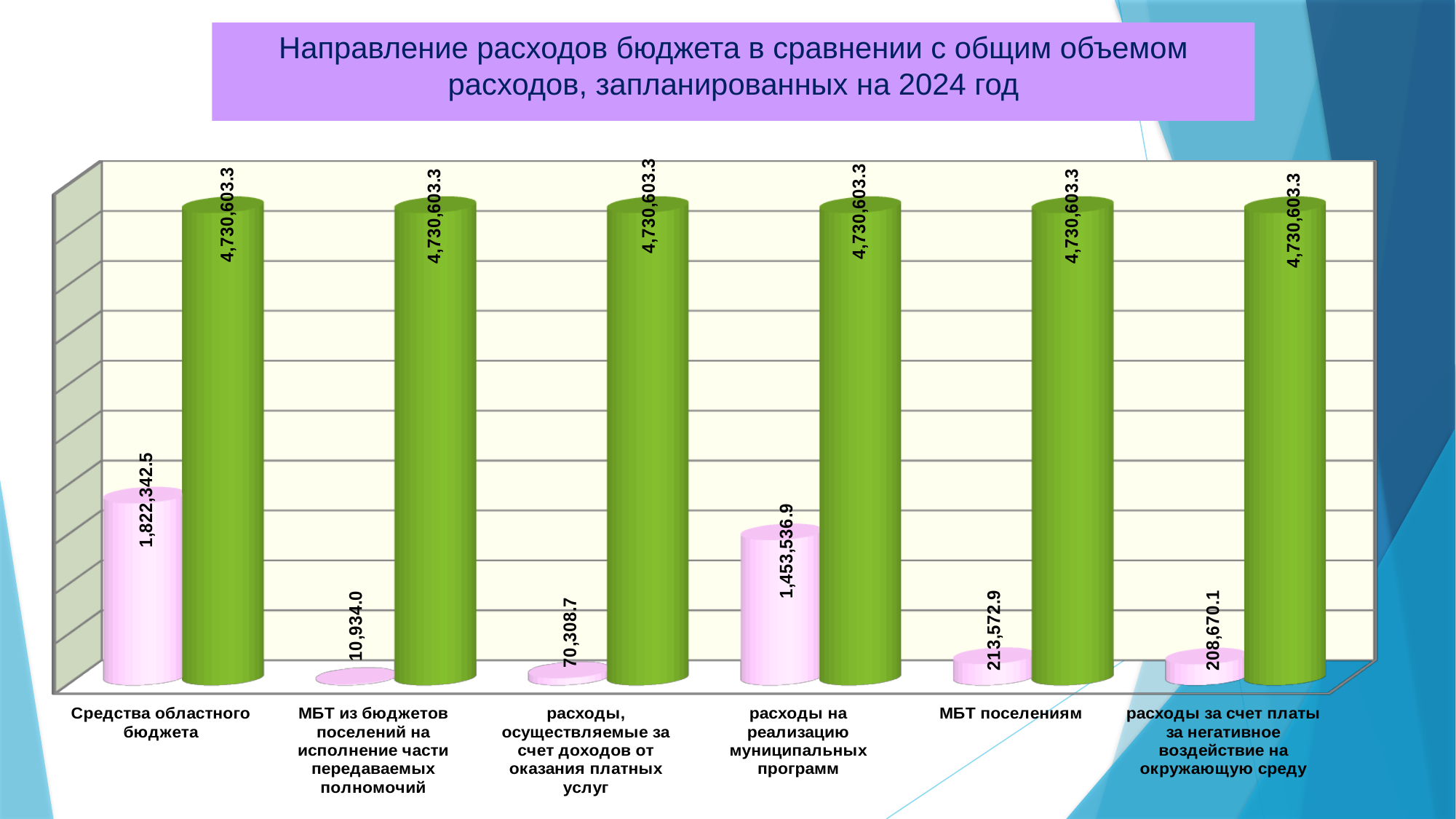
What is the value of the pink bar for "МБТ поселениям"? 213,572.9 What is the title of the chart on the slide? Направление расходов бюджета в сравнении с общим объемом расходов, запланированных на 2024 год What is the value of the pink bar for "расходы, осуществляемые за счет доходов от оказания платных услуг"? 70,308.7 Which category has the lowest pink bar value? МБТ из бюджетов поселений на исполнение части передаваемых полномочий What value is shown on each of the green bars in the chart? 4,730,603.3 What kind of chart is shown on the slide? bar chart What is the value of the pink bar for "расходы на реализацию муниципальных программ"? 1,453,536.9 Which pink bar is larger: "Средства областного бюджета" or "расходы на реализацию муниципальных программ"? Средства областного бюджета Which category has the highest pink bar value? Средства областного бюджета What is the difference between the green bar value (4,730,603.3) and the pink bar value for "Средства областного бюджета"? 2,908,260.8 How many categories are shown along the x axis of the chart? 6 What is the value of the pink bar for "Средства областного бюджета"? 1,822,342.5